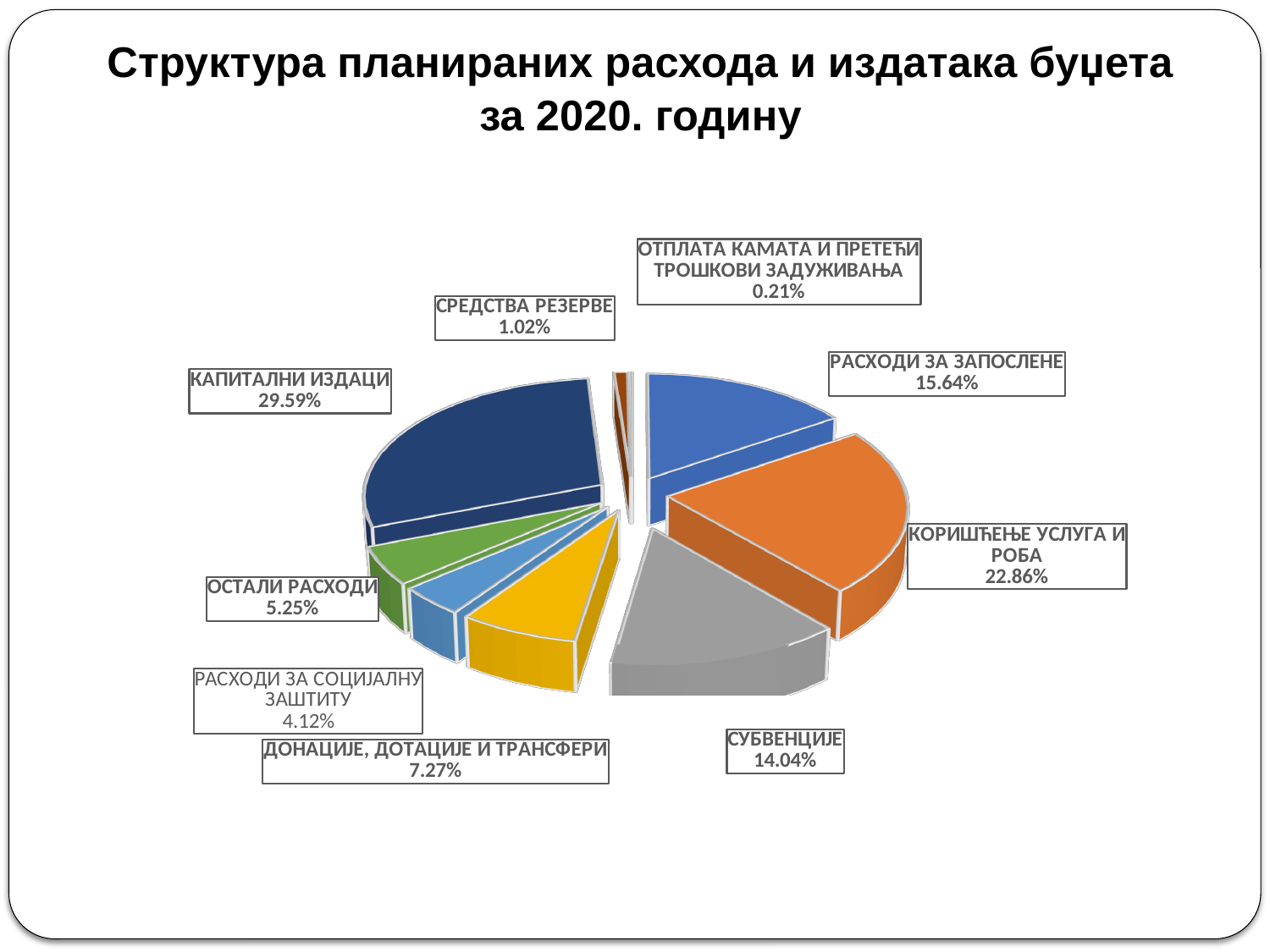
What kind of chart is shown on the slide? pie chart Which is larger, ДОНАЦИЈЕ, ДОТАЦИЈЕ И ТРАНСФЕРИ or ОСТАЛИ РАСХОДИ? ДОНАЦИЈЕ, ДОТАЦИЈЕ И ТРАНСФЕРИ What is the value shown for СУБВЕНЦИЈЕ? 14.04% What is the value shown for РАСХОДИ ЗА СОЦИЈАЛНУ ЗАШТИТУ? 4.12% Which category has the smallest share of the pie? ОТПЛАТА КАМАТА И ПРЕТЕЋИ ТРОШКОВИ ЗАДУЖИВАЊА What is the title of the chart? Структура планираних расхода и издатака буџета за 2020. годину Which category has the largest share of the pie? КАПИТАЛНИ ИЗДАЦИ What is the difference between the shares of КОРИШЋЕЊЕ УСЛУГА И РОБА and РАСХОДИ ЗА ЗАПОСЛЕНЕ? 7.22% What is the value shown for ОТПЛАТА КАМАТА И ПРЕТЕЋИ ТРОШКОВИ ЗАДУЖИВАЊА? 0.21% What share of the pie is КАПИТАЛНИ ИЗДАЦИ? 29.59% How many slices does the pie chart have? 9 What is the value shown for КОРИШЋЕЊЕ УСЛУГА И РОБА? 22.86%